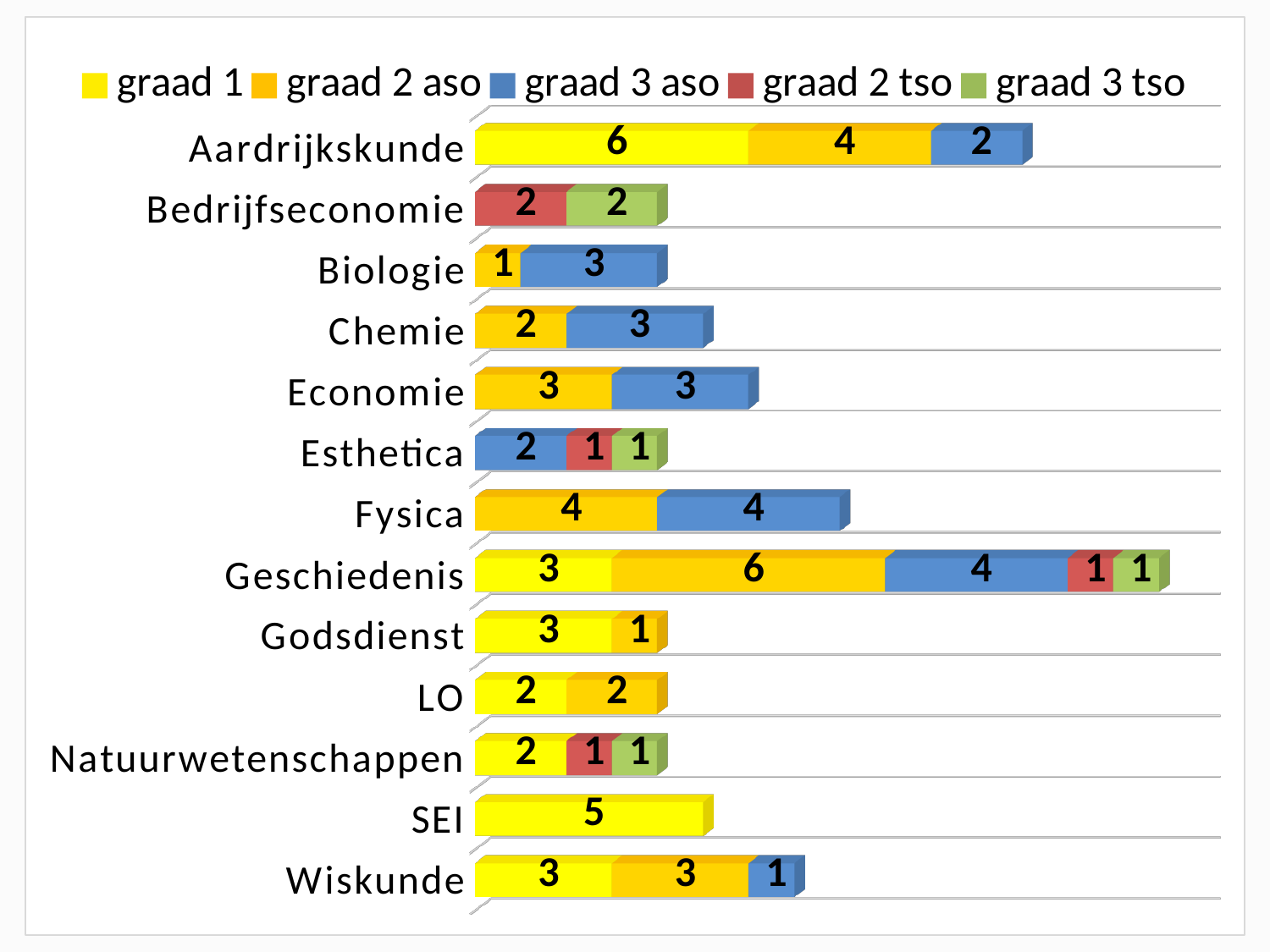
What is the total of the stacked bar for Geschiedenis? 15 What is the value for graad 2 aso in Geschiedenis? 6 What is the total of the stacked bar for Aardrijkskunde? 12 Which is larger: the graad 3 aso value for Biologie or the graad 3 aso value for Wiskunde? Biologie What type of chart is shown on the slide? stacked bar chart How many categories (subjects) are shown on the chart? 13 Which subject has the longest stacked bar overall? Geschiedenis What is the value for graad 1 in Aardrijkskunde? 6 What is the difference between the graad 2 aso value for Geschiedenis and the graad 2 aso value for Wiskunde? 3 What is the value for graad 3 aso in Fysica? 4 How many series does the legend list? 5 What is the value for graad 1 in SEI? 5